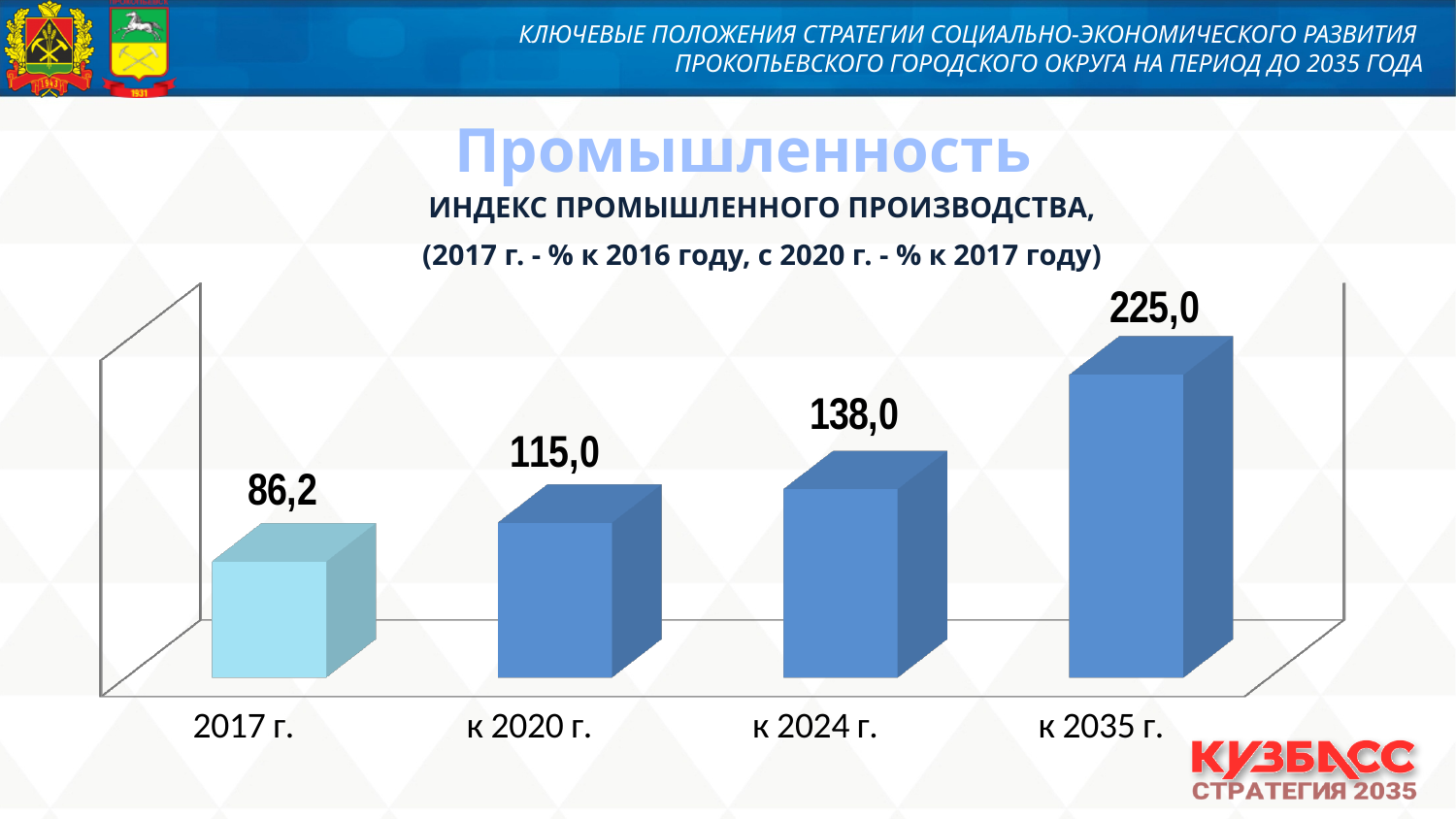
What is the difference between the values for к 2020 г. and 2017 г.? 28,8 What is the value shown for 2017 г.? 86,2 Which category has the highest value? к 2035 г. Do the values rise or fall from 2017 г. to к 2035 г.? Rise What kind of chart is shown on the slide? Bar chart Which category has the lowest value? 2017 г. Which is larger, the value for к 2024 г. or the value for к 2020 г.? к 2024 г. What is the difference between the values for к 2035 г. and к 2024 г.? 87,0 What is the value shown for к 2024 г.? 138,0 How many categories are shown on the chart? 4 What is the value shown for к 2020 г.? 115,0 What is the value shown for к 2035 г.? 225,0